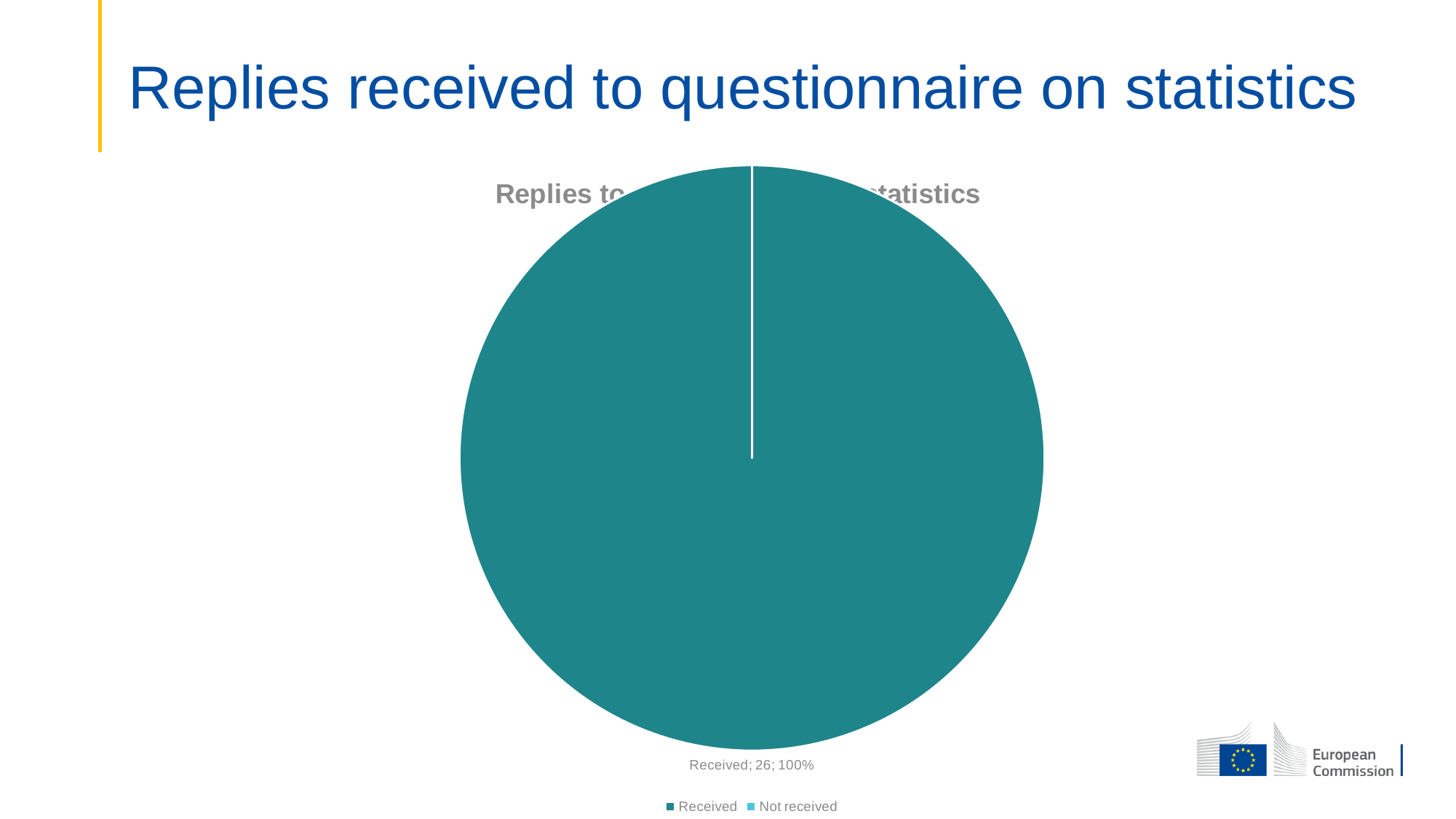
What share of the pie does the Received slice represent? 100% Is the share for Received greater or less than 50%? greater What colour is the Received slice in the pie chart? teal How many slices are visibly drawn in the pie chart? 1 What kind of chart is shown on the slide? pie chart What are the two categories listed in the legend of the pie chart? Received and Not received How many replies are labelled as Received in the pie chart? 26 Which category is larger in the pie chart, Received or Not received? Received Which category has the largest slice in the pie chart? Received How many entries does the legend of the pie chart list? 2